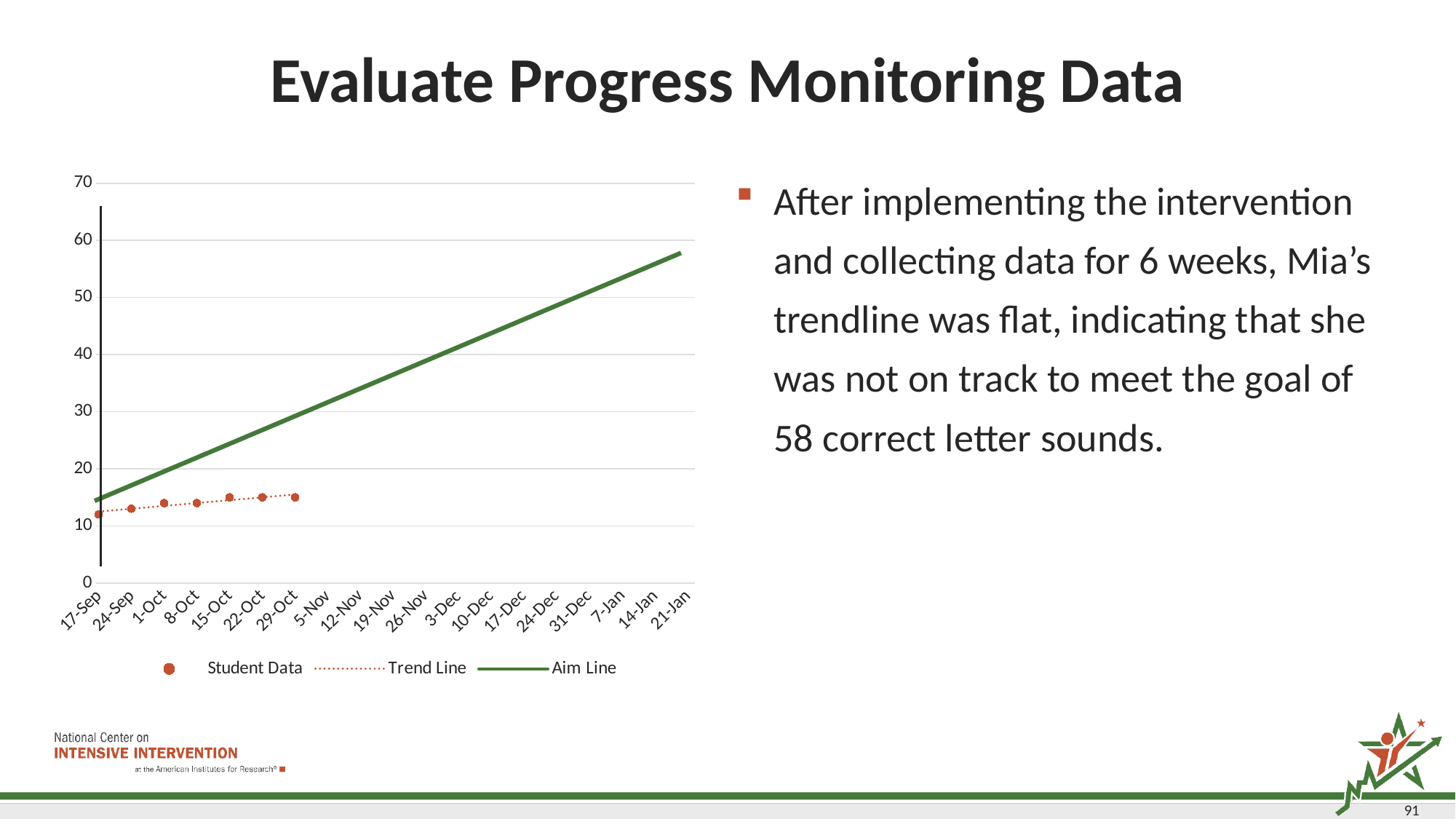
Is the Aim Line value at 21-Jan greater or less than 50? greater Is the Student Data value for 29-Oct greater or less than 20? less What are the three series listed in the chart legend? Student Data, Trend Line, Aim Line What is the highest value shown on the y axis of the chart? 70 Does the Aim Line rise or fall from 17-Sep to 21-Jan? rise At 29-Oct, which is higher: the Aim Line or the Student Data point? Aim Line Is the Aim Line value at 17-Sep greater or less than 20? less How many series does the chart legend list? 3 How many Student Data points are plotted on the chart? 7 What kind of chart is shown on the slide? line chart How many date labels are shown on the x axis of the chart? 19